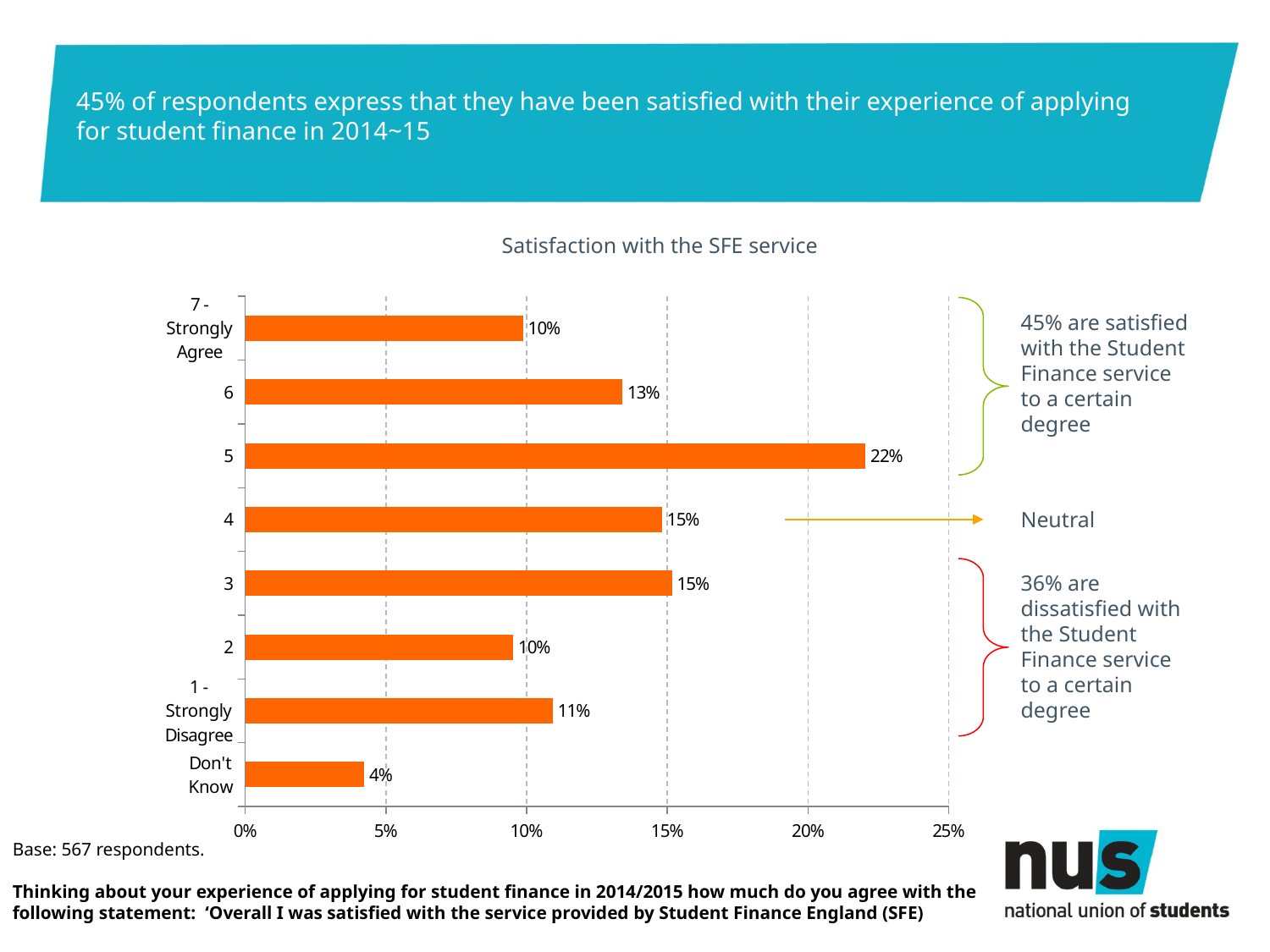
What kind of chart is shown on the slide? Bar chart What is the difference between the values for category 5 and category 6? 9% Is the value for category 5 greater or less than 20%? greater Which category has the lowest value in the chart? Don't Know Which category has the highest value in the chart? 5 What is the value for 1 - Strongly Disagree? 11% Which has a larger value, category 6 or category 2? 6 What percentage of respondents chose 7 - Strongly Agree? 10% What percentage of respondents answered Don't Know? 4% What is the title of the chart? Satisfaction with the SFE service How many categories are shown in the chart? 8 What is the value for category 5 in the Satisfaction with the SFE service chart? 22%